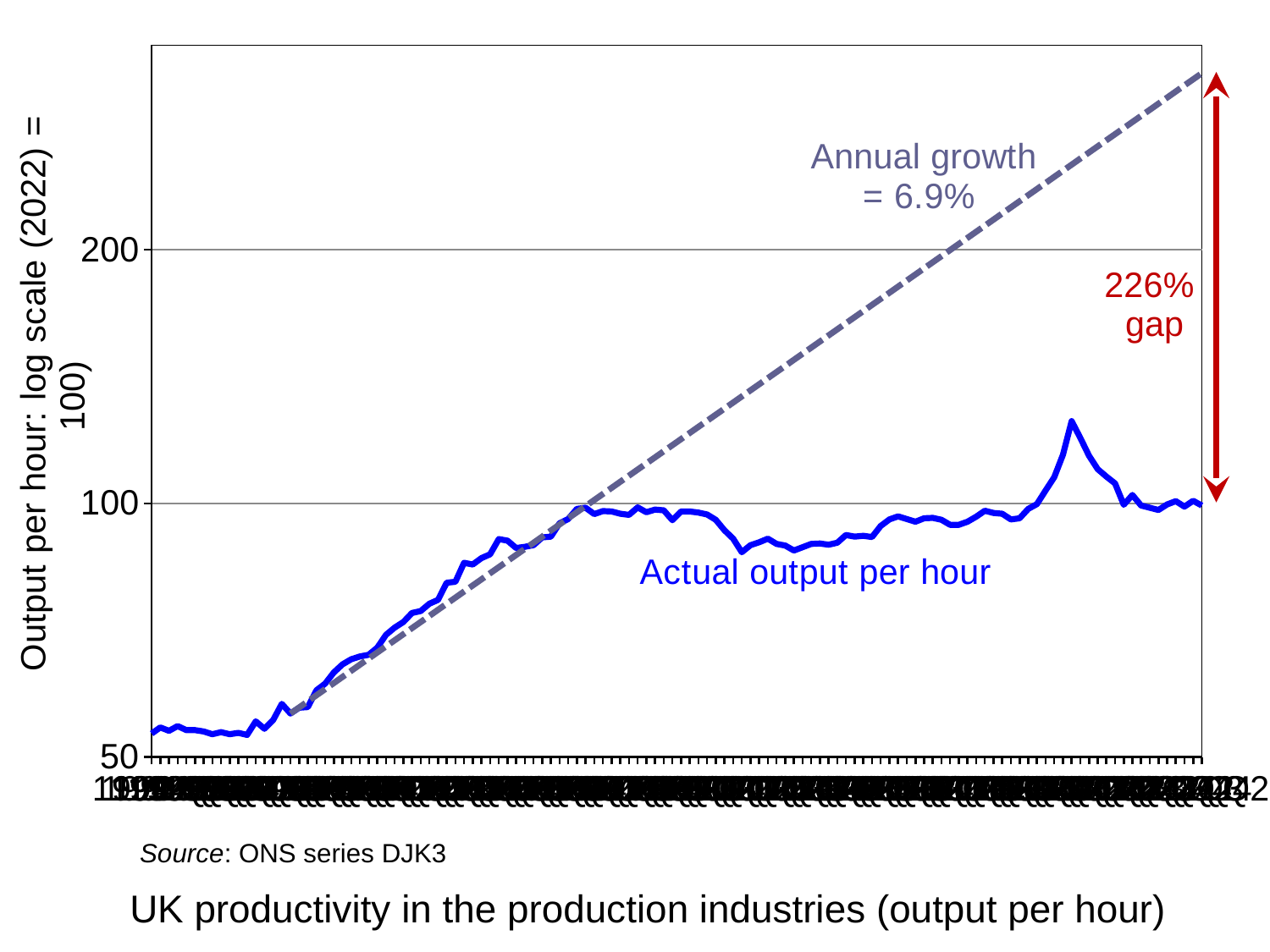
Is the value of actual output per hour at the start of the series greater or less than 100? less What kind of chart is shown on the slide? line chart What is the source of the data given on the slide? ONS series DJK3 What annual growth rate is shown for the dashed trend line? 6.9% At the right end of the chart, which is higher: the dashed trend line or the actual output per hour line? the dashed trend line What is the label of the solid blue line? Actual output per hour What is the size of the gap between the trend line and actual output per hour at the end of the series, as labelled on the chart? 226% Is the highest peak of the actual output per hour line greater or less than 100? greater What is the title of the chart? UK productivity in the production industries (output per hour) Is the value of the dashed trend line at the right end of the chart greater or less than 200? greater Does the dashed trend line rise or fall along the x axis? rise How many lines are plotted on the chart? 2